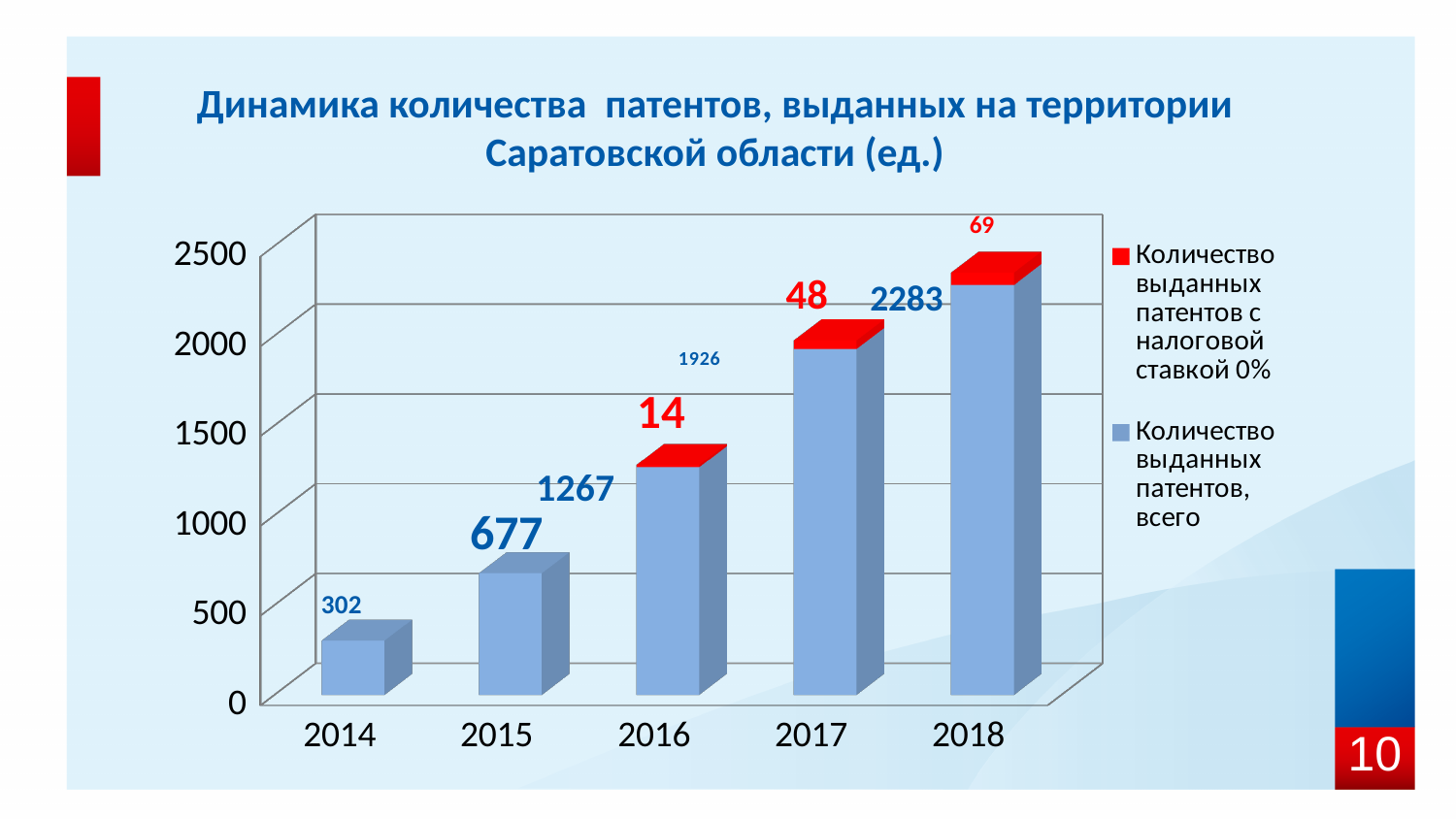
Do the values in the series "Количество выданных патентов, всего" rise or fall from 2014 to 2018? rise Which year has the larger value in the series "Количество выданных патентов, всего": 2015 or 2016? 2016 What is the value for 2018 in the series "Количество выданных патентов, всего"? 2283 Which year has the highest value in the series "Количество выданных патентов, всего"? 2018 What is the value for 2017 in the series "Количество выданных патентов с налоговой ставкой 0%"? 48 How many series does the legend list? 2 How many years are shown on the x axis of the chart? 5 What is the value for 2016 in the series "Количество выданных патентов с налоговой ставкой 0%"? 14 What is the difference between the 2018 and 2016 values in the series "Количество выданных патентов с налоговой ставкой 0%"? 55 What is the difference between the 2018 and 2017 values in the series "Количество выданных патентов, всего"? 357 What is the value for 2014 in the series "Количество выданных патентов, всего"? 302 Which year has the lowest value in the series "Количество выданных патентов, всего"? 2014